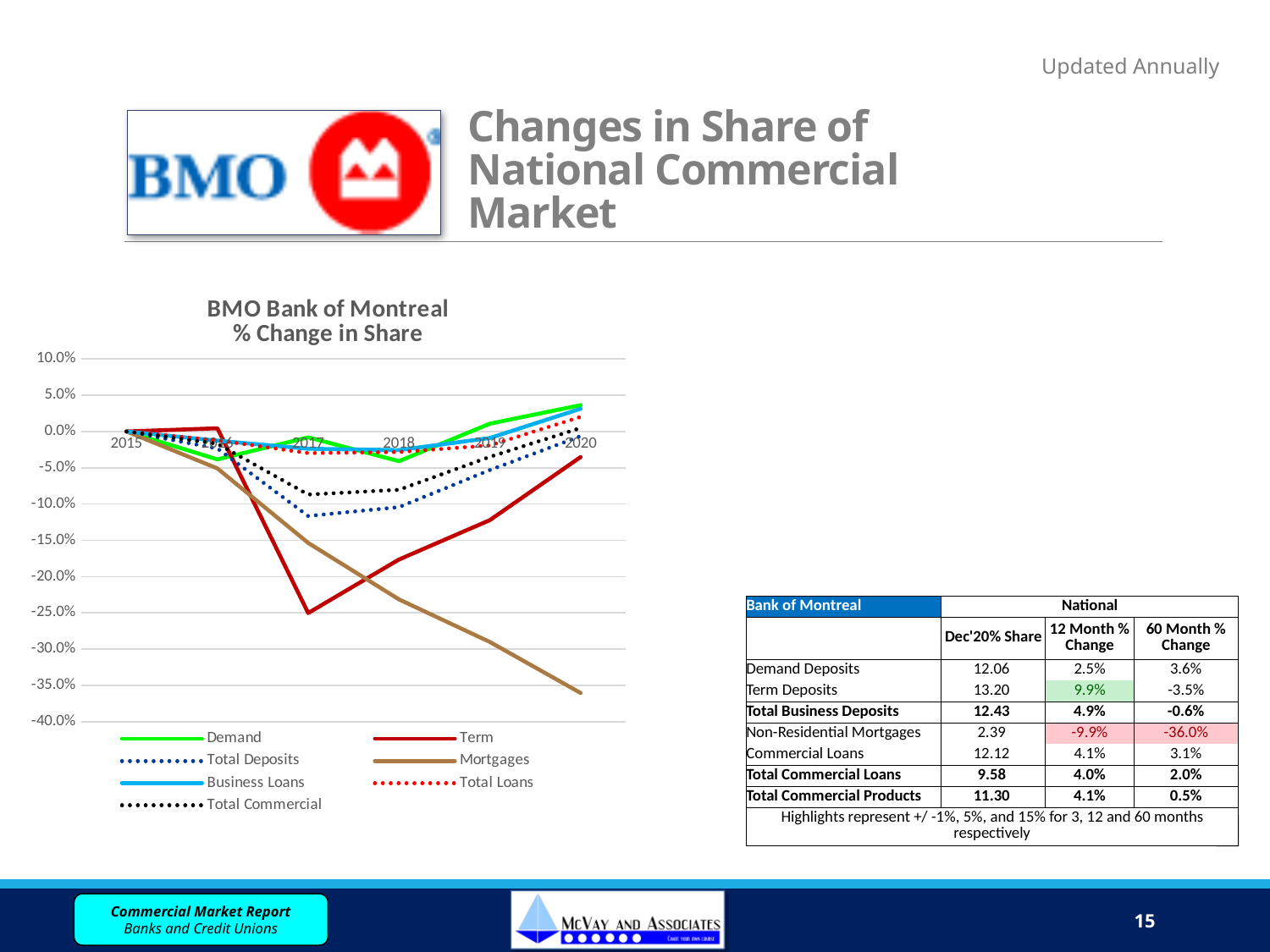
In 2017, which series has the lower value, Term or Mortgages? Term Which series is drawn as a solid brown line? Mortgages Does the Mortgages line rise or fall from 2015 to 2020? fall Is the value for Term in 2017 greater or less than -20.0%? less What is the title of the chart? BMO Bank of Montreal % Change in Share What kind of chart is shown on the slide? line chart Does the Term line rise or fall from 2017 to 2020? rise Is the value for Mortgages in 2020 greater or less than -30.0%? less Is the value for Demand in 2020 greater or less than 0.0%? greater How many years are shown along the x axis of the chart? 6 Which series has the lowest value in 2020? Mortgages How many series does the legend of the BMO Bank of Montreal % Change in Share chart list? 7